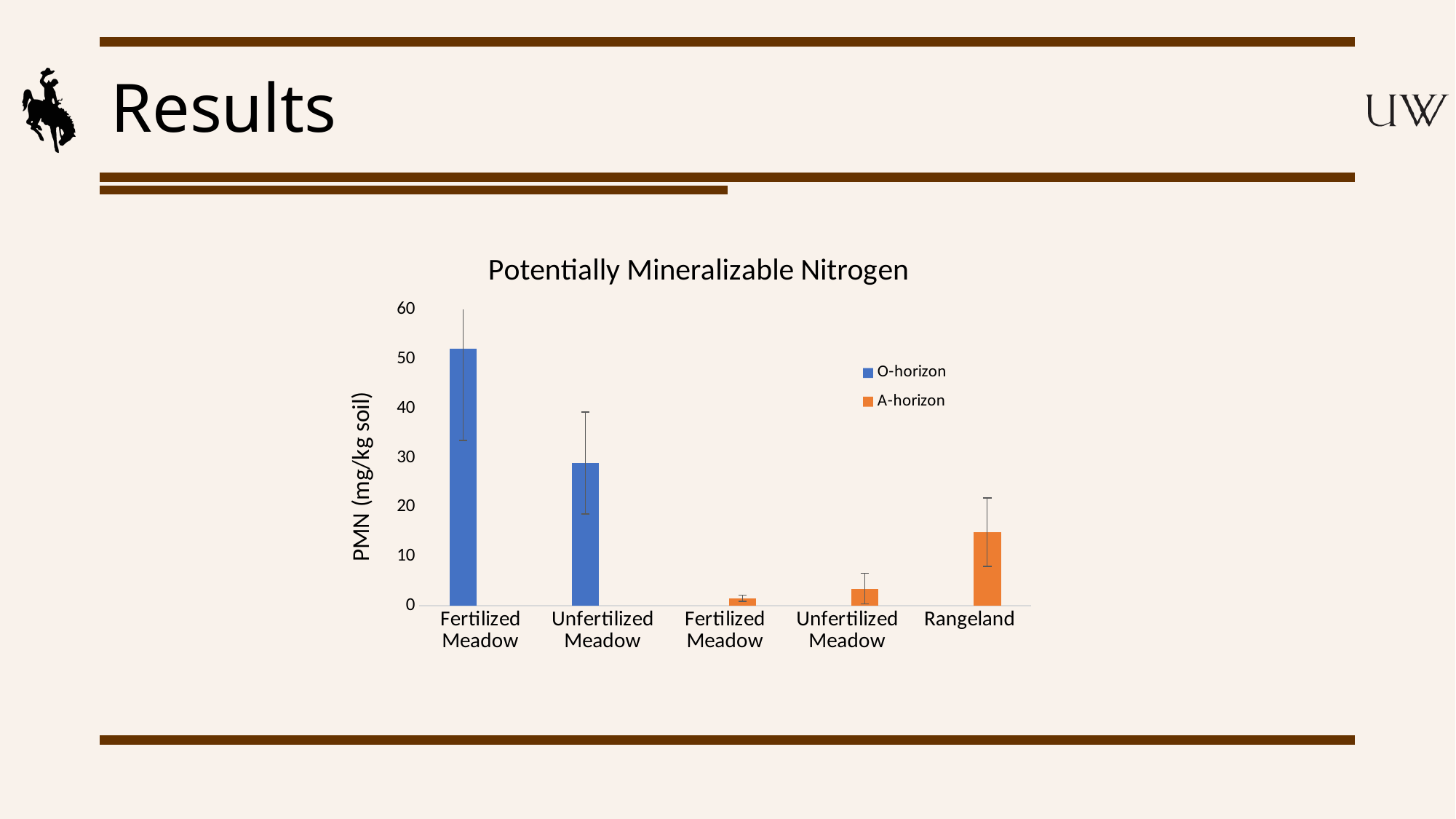
Which bar has the highest value in the chart? Fertilized Meadow (O-horizon) Which bar has the lowest value in the chart? Fertilized Meadow (A-horizon) How many series does the chart legend list? 2 How many bars are plotted in the chart? 5 Which is larger: the O-horizon Fertilized Meadow bar or the O-horizon Unfertilized Meadow bar? O-horizon Fertilized Meadow What is the title of the chart? Potentially Mineralizable Nitrogen What are the two series named in the legend? O-horizon and A-horizon Is the value for the Rangeland bar greater or less than 10? greater What kind of chart is shown on the slide? bar chart Is the value for the O-horizon Fertilized Meadow bar greater or less than 50? greater Which is larger: the Rangeland bar or the A-horizon Unfertilized Meadow bar? Rangeland